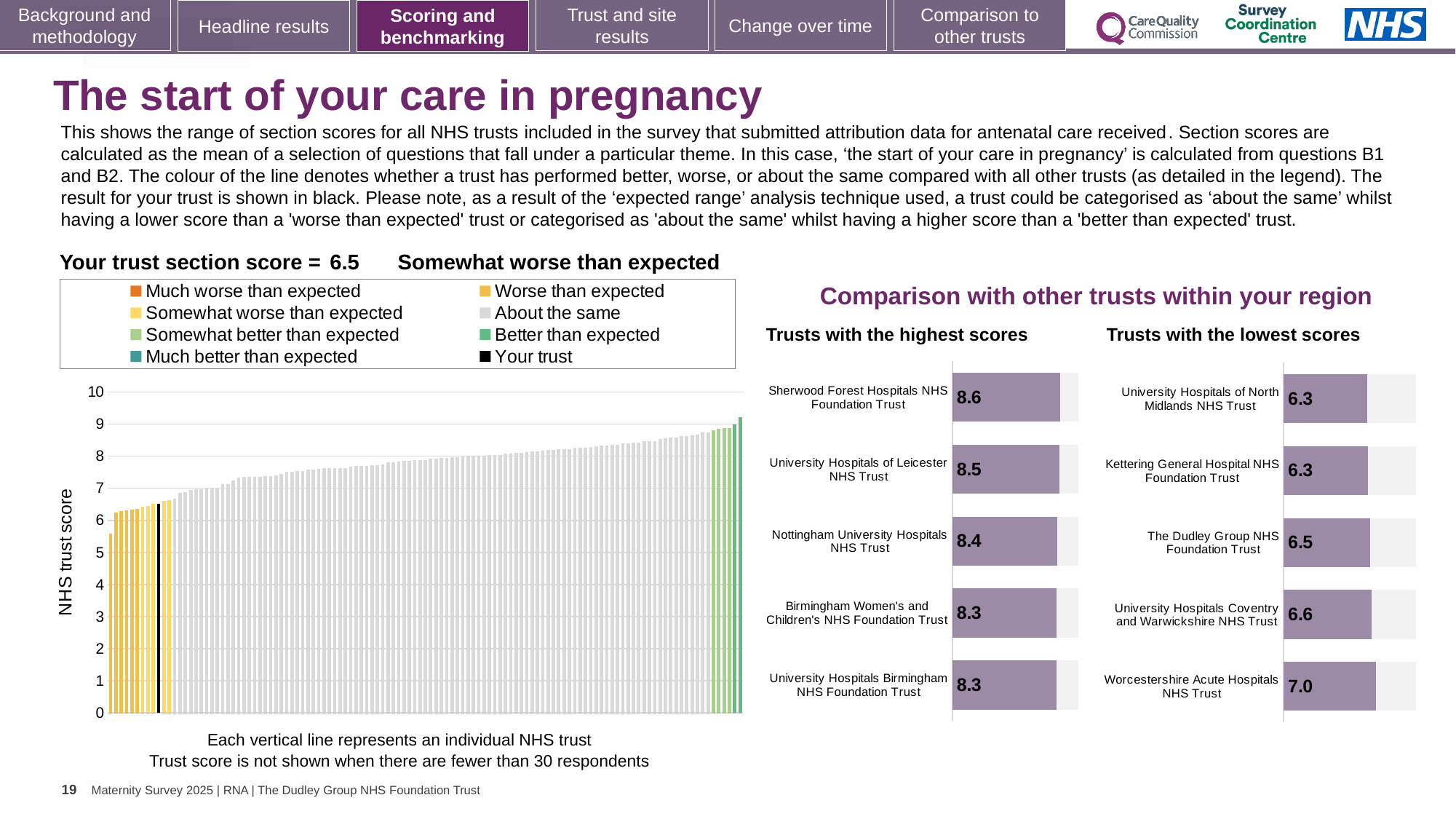
On the main 'NHS trust score' chart on the left, do the bar values rise or fall from left to right? rise On the main 'NHS trust score' chart on the left, is the value of the lowest (leftmost) bar greater or less than 6? less On the 'Trusts with the highest scores' chart, which trust has the highest score? Sherwood Forest Hospitals NHS Foundation Trust On the main 'NHS trust score' chart on the left, what is the section score for your trust (the black bar)? 6.5 On the 'Trusts with the lowest scores' chart, what is the score for The Dudley Group NHS Foundation Trust? 6.5 How many entries does the legend above the main 'NHS trust score' chart list? 8 On the 'Trusts with the highest scores' chart, what is the difference between the scores of Sherwood Forest Hospitals NHS Foundation Trust and Nottingham University Hospitals NHS Trust? 0.2 How many trusts are shown on the 'Trusts with the lowest scores' chart? 5 On the 'Trusts with the highest scores' chart, what is the score for Sherwood Forest Hospitals NHS Foundation Trust? 8.6 On the 'Trusts with the lowest scores' chart, what is the difference between the scores of Worcestershire Acute Hospitals NHS Trust and The Dudley Group NHS Foundation Trust? 0.5 On the 'Trusts with the lowest scores' chart, which trust has the highest score? Worcestershire Acute Hospitals NHS Trust On the 'Trusts with the highest scores' chart, which has the higher score: University Hospitals of Leicester NHS Trust or Birmingham Women's and Children's NHS Foundation Trust? University Hospitals of Leicester NHS Trust